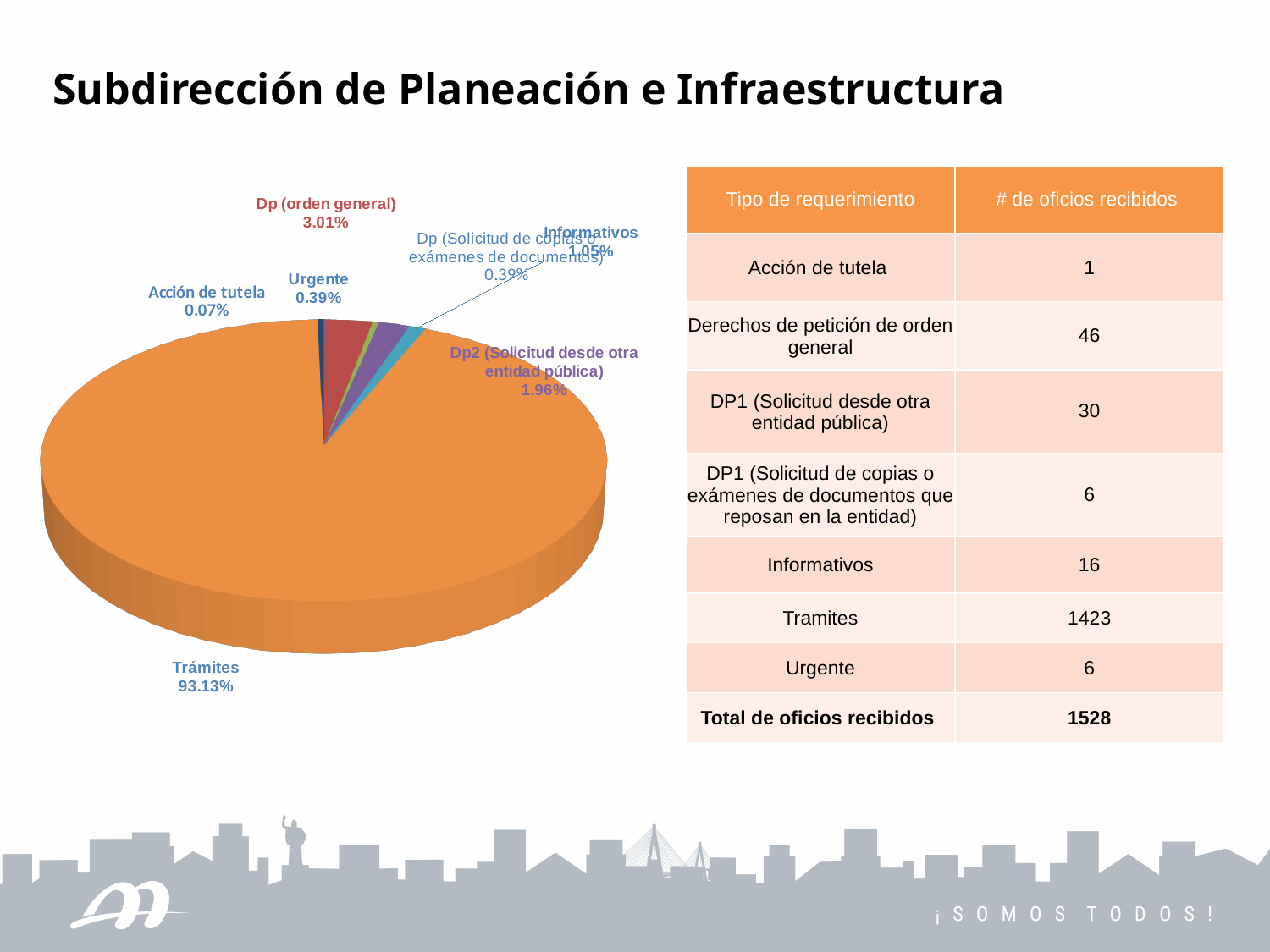
What kind of chart is shown on the slide? Pie chart What colour is the Trámites slice of the pie? Orange What share of the pie does Dp (orden general) represent? 3.01% What share of the pie does Trámites represent? 93.13% Which category has the smallest slice of the pie? Acción de tutela Which category has the largest slice of the pie? Trámites What share of the pie does Dp2 (Solicitud desde otra entidad pública) represent? 1.96% How many slices does the pie chart have? 7 What is the difference in percentage points between the Trámites slice and the Dp (orden general) slice? 90.12 Which slice is larger, Dp (orden general) or Dp2 (Solicitud desde otra entidad pública)? Dp (orden general)